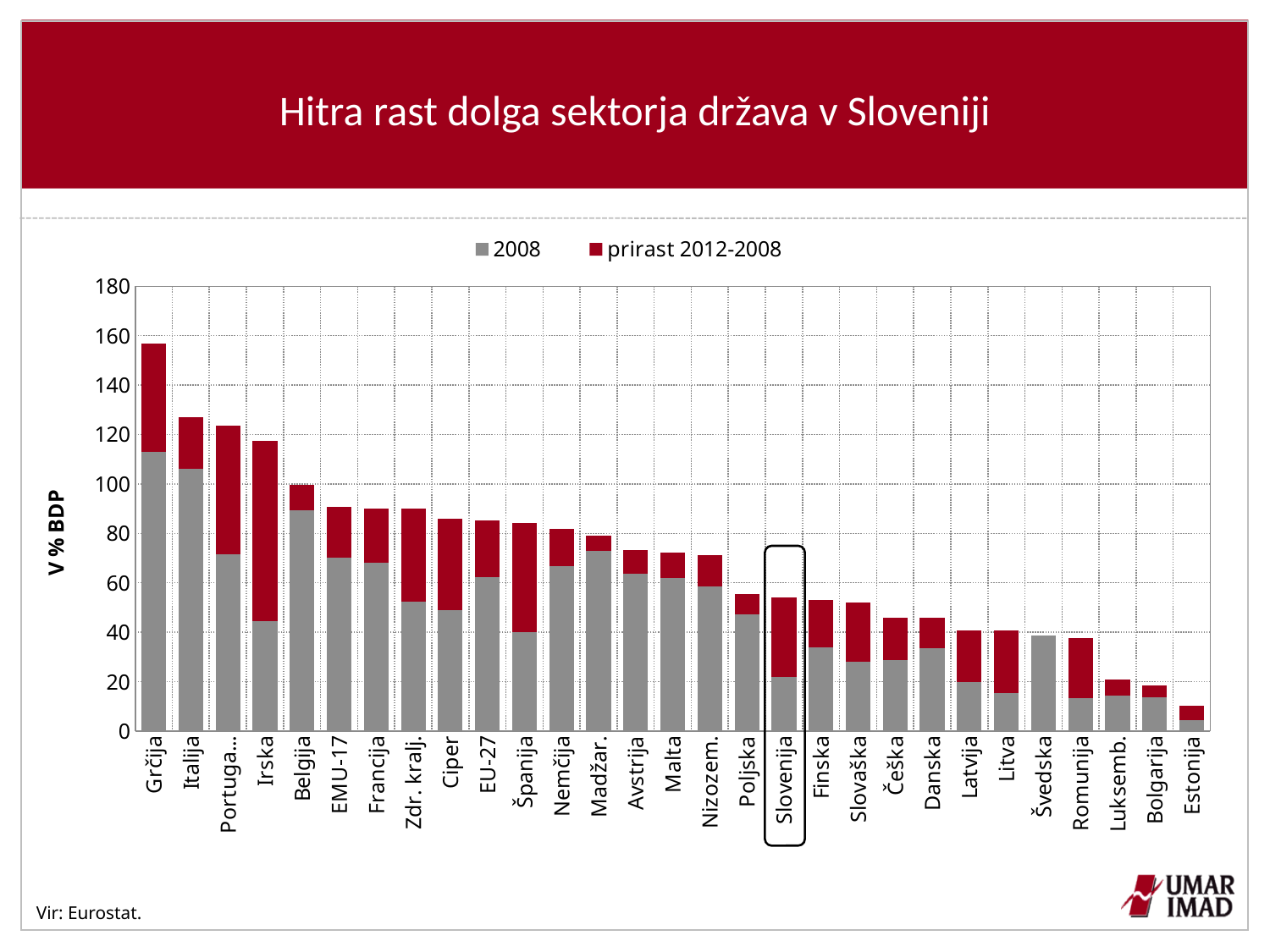
How many series does the legend list? 2 How many countries or groups are shown on the x axis? 29 Is the 2008 value for Slovenija greater or less than 40? less What is the label on the vertical axis? V % BDP Is the total value for Slovenija greater or less than 40? greater Do the total bar heights rise or fall moving from left to right along the x axis? fall Is the total value for Grčija greater or less than 140? greater What kind of chart is shown on the slide? stacked bar chart Which category has the highest total bar? Grčija Which category has the lowest total bar? Estonija What are the two series named in the legend? 2008 and prirast 2012-2008 Which has the larger 2008 value, Irska or Belgija? Belgija